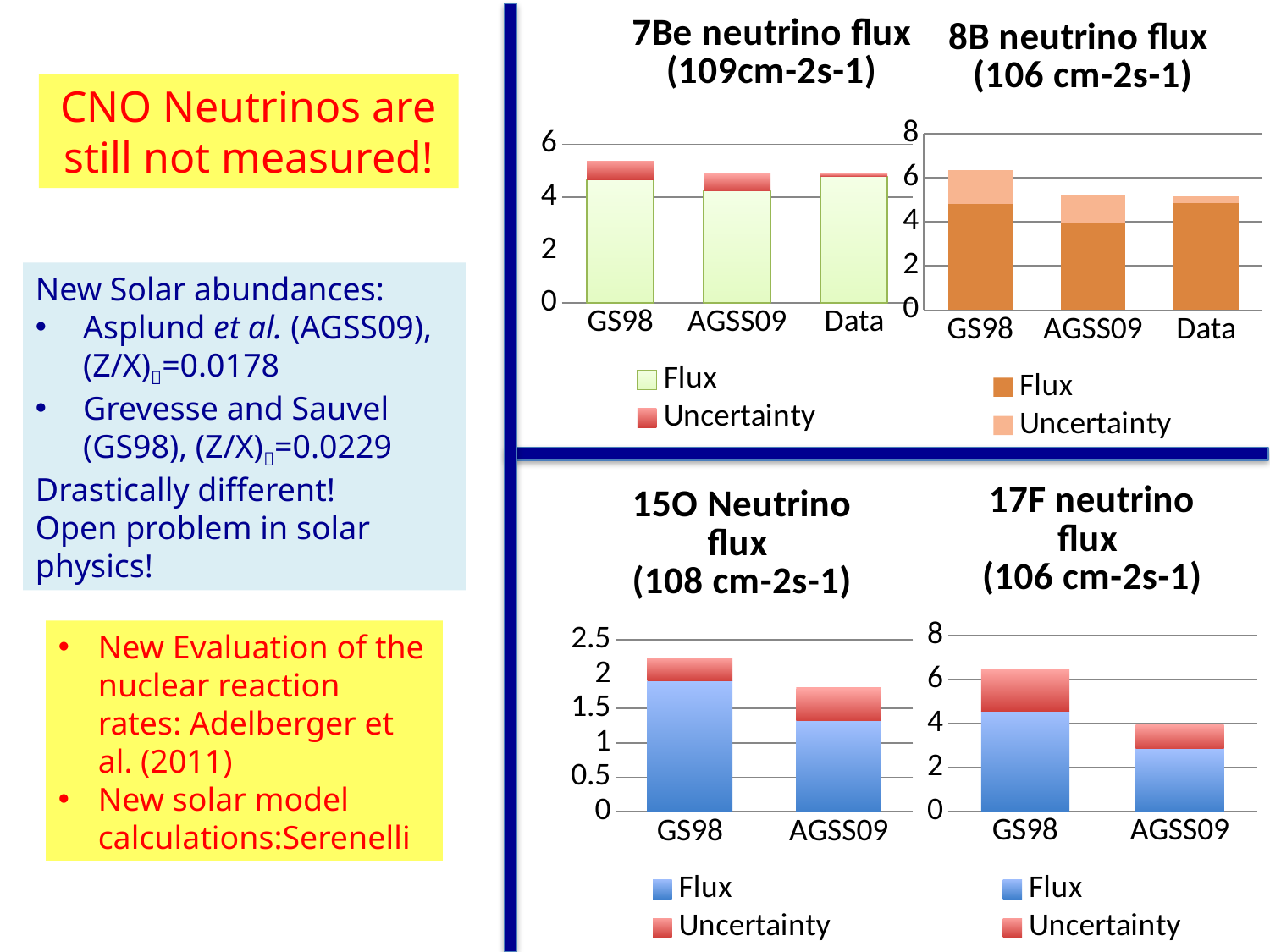
How many categories are shown on the x axis of the 15O Neutrino flux chart? 2 What are the two legend entries of the 15O Neutrino flux chart? Flux and Uncertainty How many categories are shown on the x axis of the 8B neutrino flux chart? 3 In the 8B neutrino flux chart, is the top of the GS98 stacked bar greater or less than 6? greater How many series does the legend of the 17F neutrino flux chart list? 2 What kind of chart is the 7Be neutrino flux chart? bar chart In the 8B neutrino flux chart, which category has the smallest Flux segment? AGSS09 In the 7Be neutrino flux chart, which category has the tallest stacked bar? GS98 In the 17F neutrino flux chart, which category has the taller stacked bar, GS98 or AGSS09? GS98 In the 15O Neutrino flux chart, is the Flux value for AGSS09 greater or less than 1.5? less In the 17F neutrino flux chart, is the Flux value for AGSS09 greater or less than 4? less